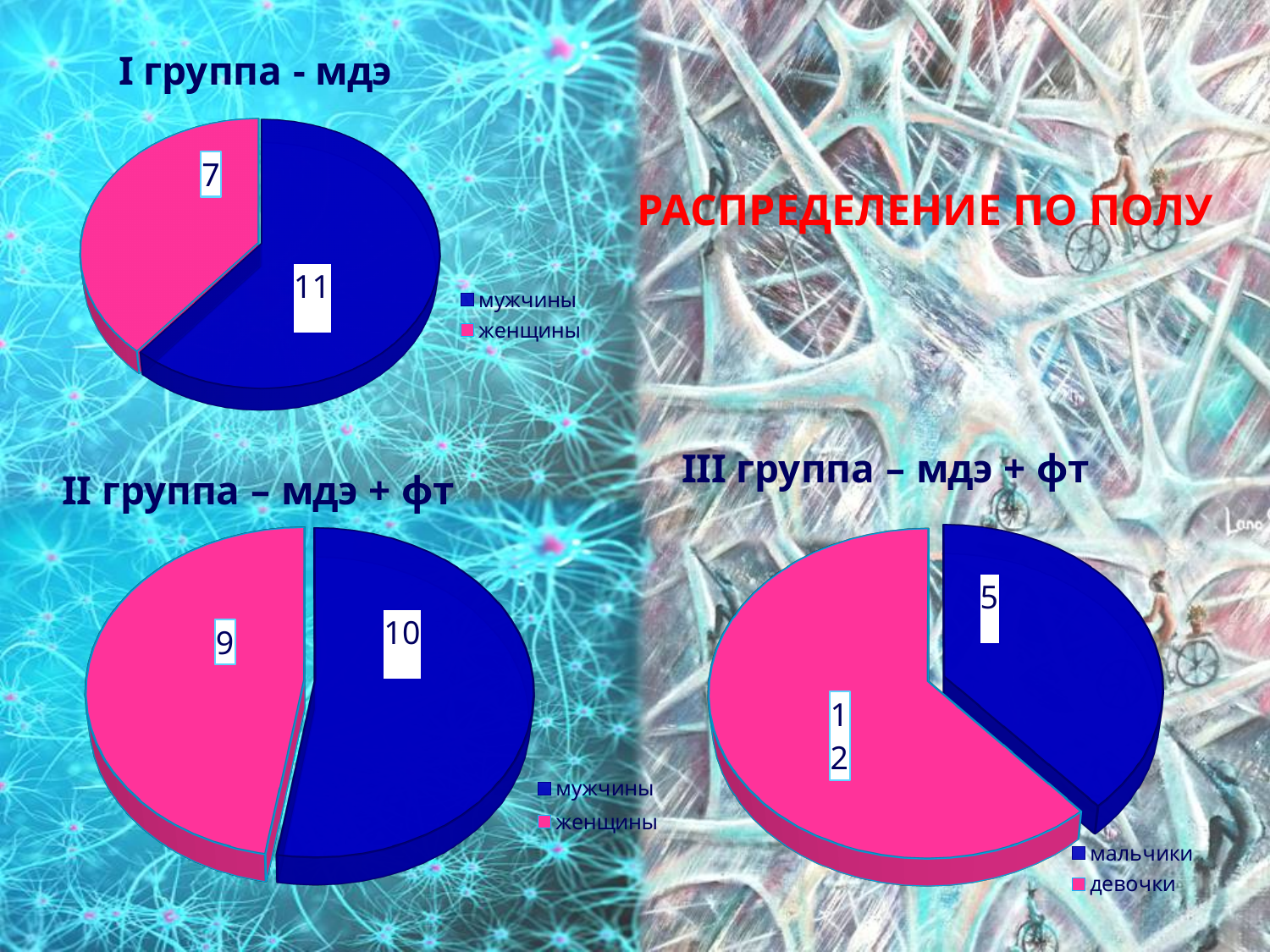
In the 'II группа – мдэ + фт' chart, what is the value for женщины? 9 In the 'I группа - мдэ' chart, what is the value for мужчины? 11 In the 'II группа – мдэ + фт' chart, what is the total of the two slices? 19 In the 'III группа – мдэ + фт' chart, what is the value for девочки? 12 How many entries does the legend of the 'III группа – мдэ + фт' chart list? 2 What kind of chart is used for 'I группа - мдэ'? pie chart In the 'III группа – мдэ + фт' chart, which category has the smaller slice? мальчики In the 'III группа – мдэ + фт' chart, what is the value for мальчики? 5 In the 'I группа - мдэ' chart, what is the value for женщины? 7 In the 'II группа – мдэ + фт' chart, what is the value for мужчины? 10 In the 'I группа - мдэ' chart, which category has the larger slice? мужчины In the 'I группа - мдэ' chart, what is the difference between мужчины and женщины? 4